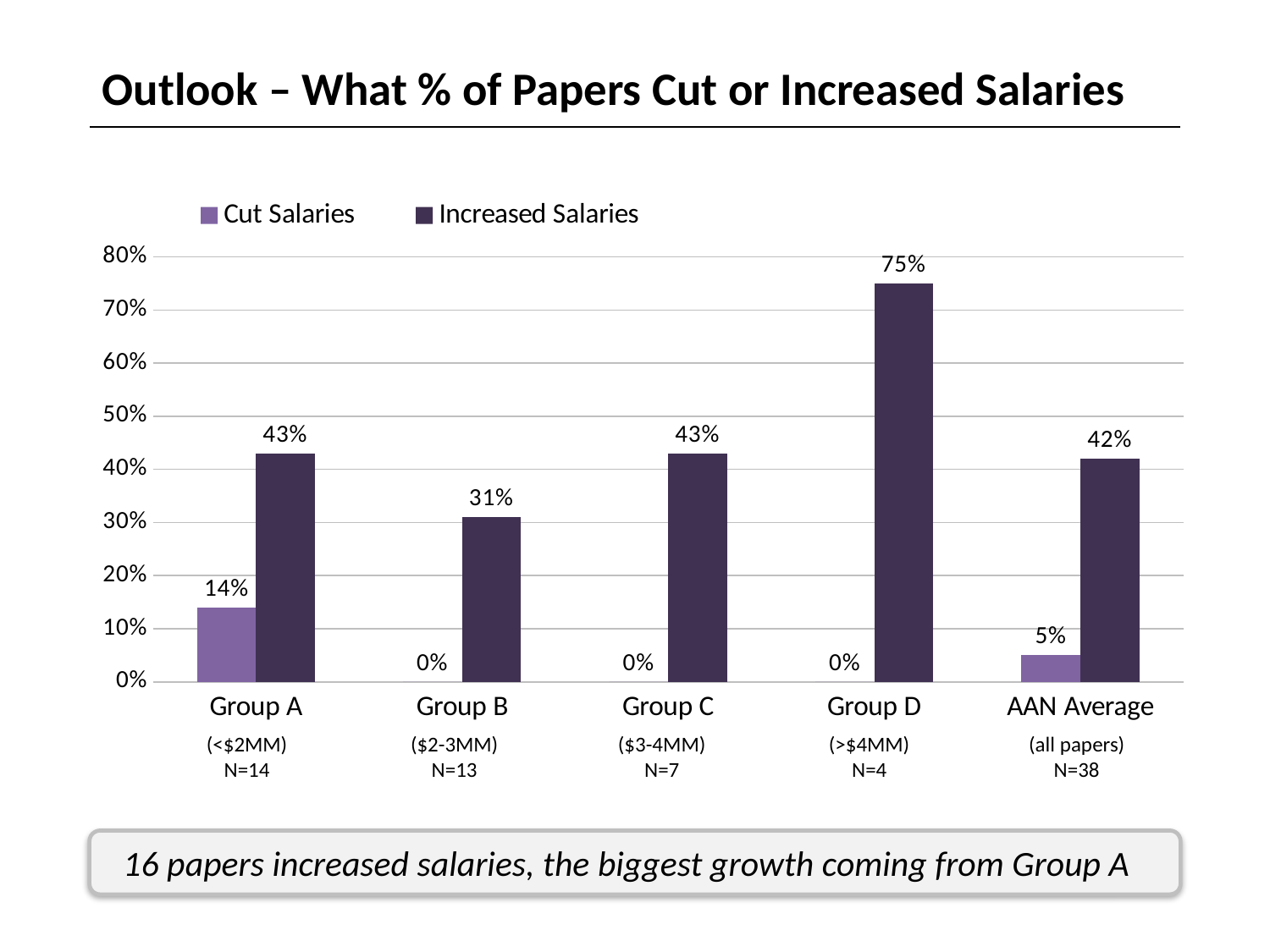
What percentage of Group A papers cut salaries? 14% Which is larger for Group A: the Cut Salaries value or the Increased Salaries value? Increased Salaries Which group has the highest percentage of papers that increased salaries? Group D How many series does the legend list? 2 What kind of chart is shown on the slide? Bar chart What percentage of Group D papers increased salaries? 75% How many categories are shown on the x axis? 5 What percentage of Group B papers increased salaries? 31% What is the difference between the Increased Salaries values for Group D and Group B? 44% What are the two series named in the legend? Cut Salaries and Increased Salaries What is the AAN Average value for Increased Salaries? 42% Which category has the lowest Increased Salaries value? Group B